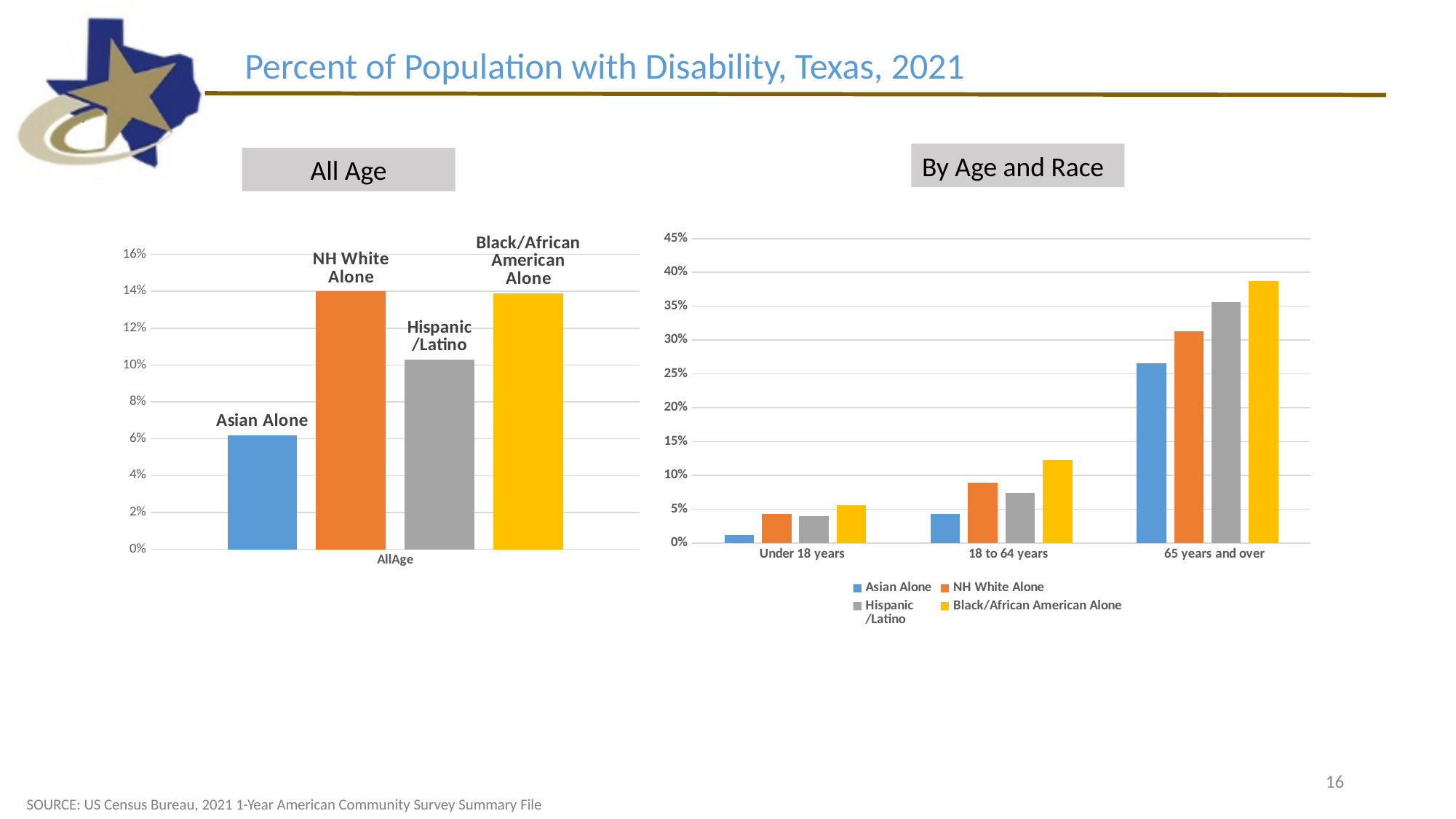
In the "All Age" chart, which is larger, the value for NH White Alone or the value for Hispanic/Latino? NH White Alone What kind of chart is the "All Age" chart on the left? bar chart In the "By Age and Race" chart, do the values for Asian Alone rise or fall as the age groups move from Under 18 years to 65 years and over? rise In the "By Age and Race" chart, which colour represents NH White Alone? orange In the "All Age" chart, is the value for Asian Alone greater or less than 8%? less In the "All Age" chart, which group has the lowest percent of population with disability? Asian Alone In the "By Age and Race" chart, is the value for Black/African American Alone in the 18 to 64 years group greater or less than 10%? greater In the "By Age and Race" chart, which group has the highest value for 65 years and over? Black/African American Alone How many series does the legend of the "By Age and Race" chart list? 4 How many bars are shown in the "All Age" chart? 4 How many age groups are shown on the x axis of the "By Age and Race" chart? 3